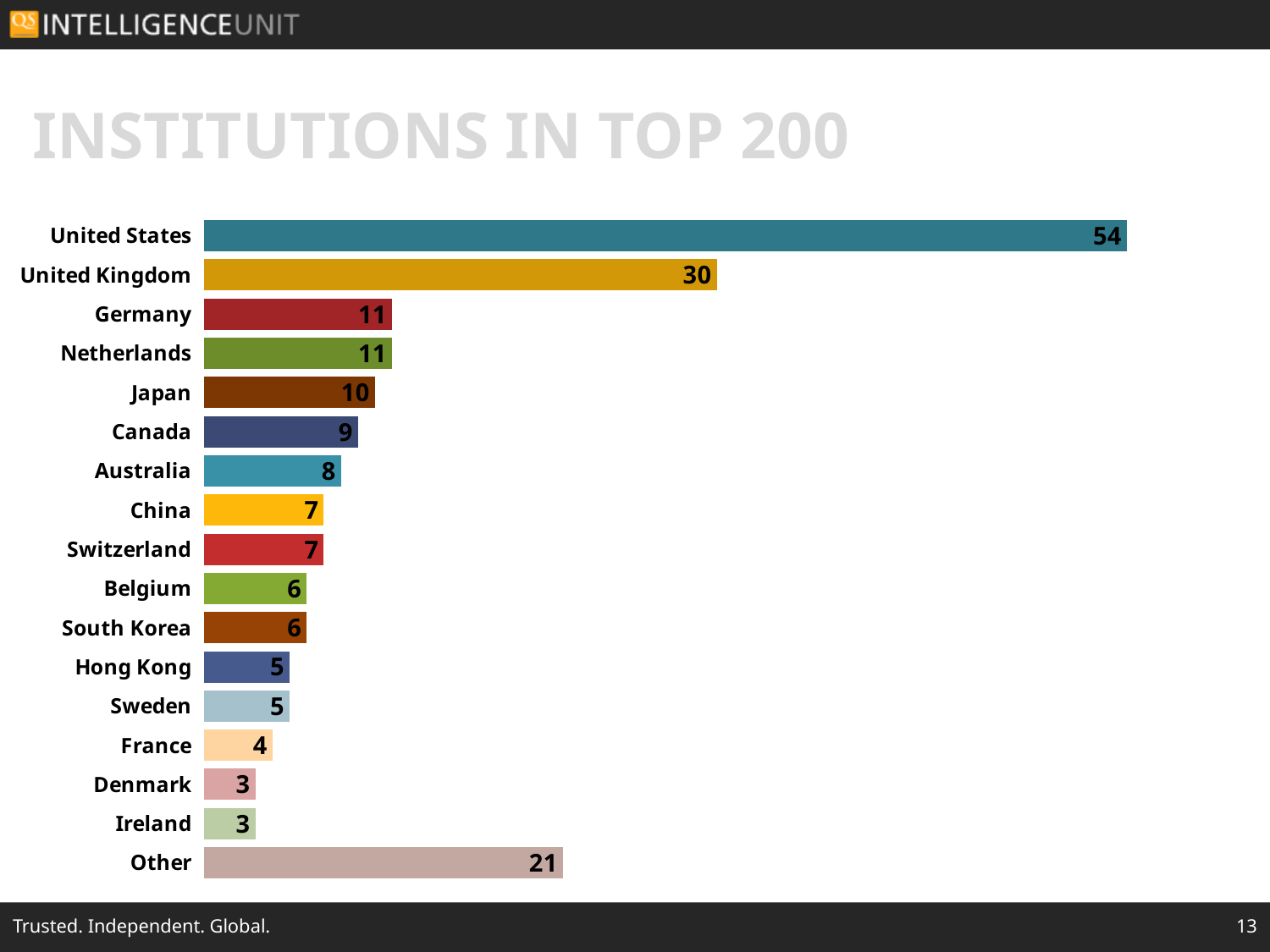
What is the value shown for Japan? 10 What is the difference between the values for the United States and the United Kingdom? 24 Which has a larger value, Australia or Belgium? Australia Which has a larger value, Sweden or Switzerland? Switzerland Which categories have the lowest value on the chart? Denmark and Ireland Which country has the highest number of institutions in the top 200? United States How many categories are shown on the chart? 17 What is the difference between the values for Canada and France? 5 How many institutions in the top 200 does the United States have? 54 What is the title of the slide? INSTITUTIONS IN TOP 200 What kind of chart is shown on the slide? Bar chart What is the value shown for the Other category? 21